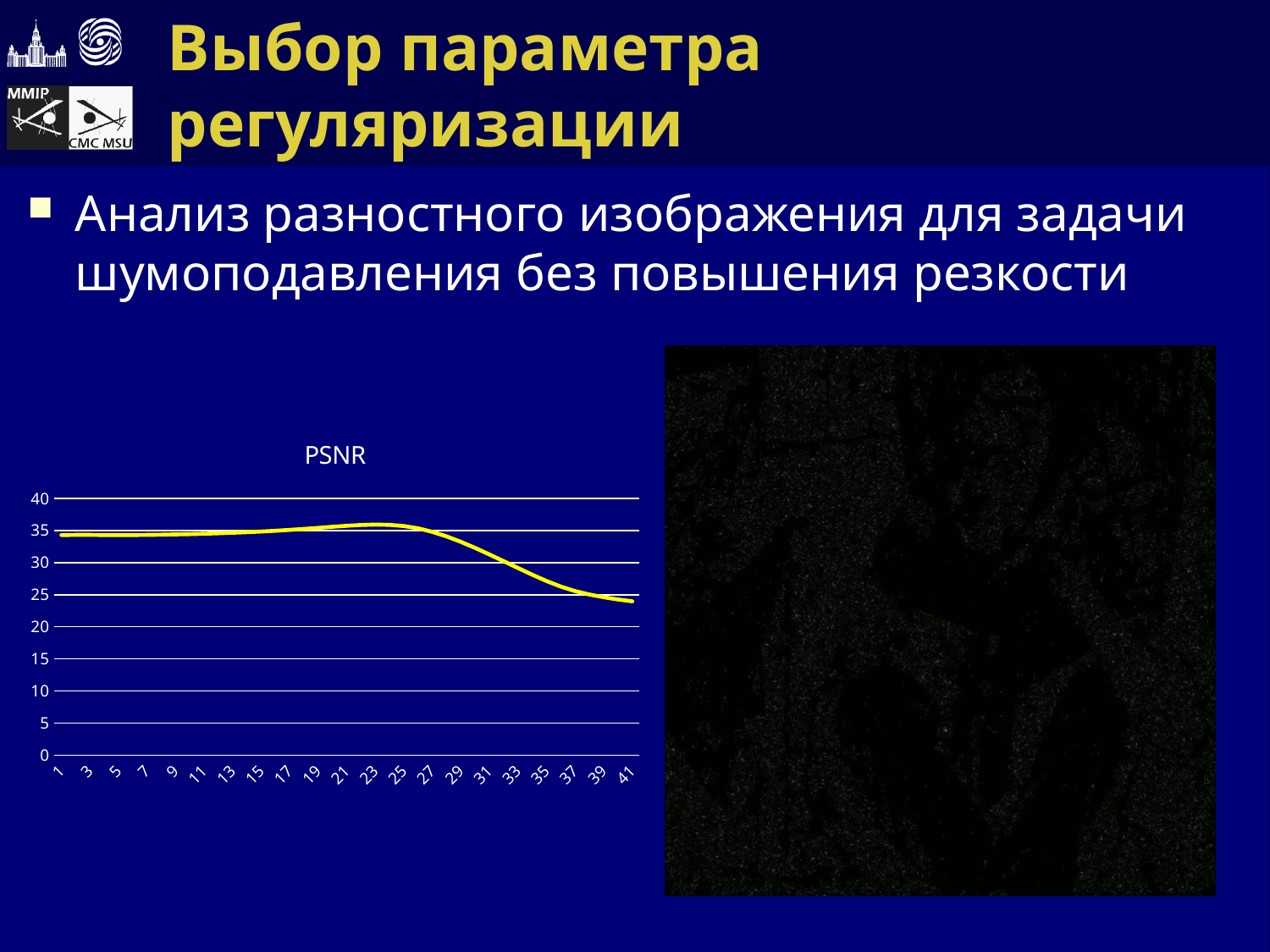
Is the PSNR value at x = 23 greater or less than 30? greater Which is larger, the PSNR value at x = 21 or at x = 37? x = 21 What is the highest value shown on the y axis of the chart? 40 Which is larger, the PSNR value at x = 1 or at x = 41? x = 1 Is the PSNR value at x = 41 greater or less than 20? greater Which x value has the lowest PSNR on the chart? 41 Is the PSNR value at x = 35 greater or less than 35? less Does the PSNR line rise or fall between x = 25 and x = 41? fall What kind of chart is shown on the slide? line chart What is the title of the chart? PSNR